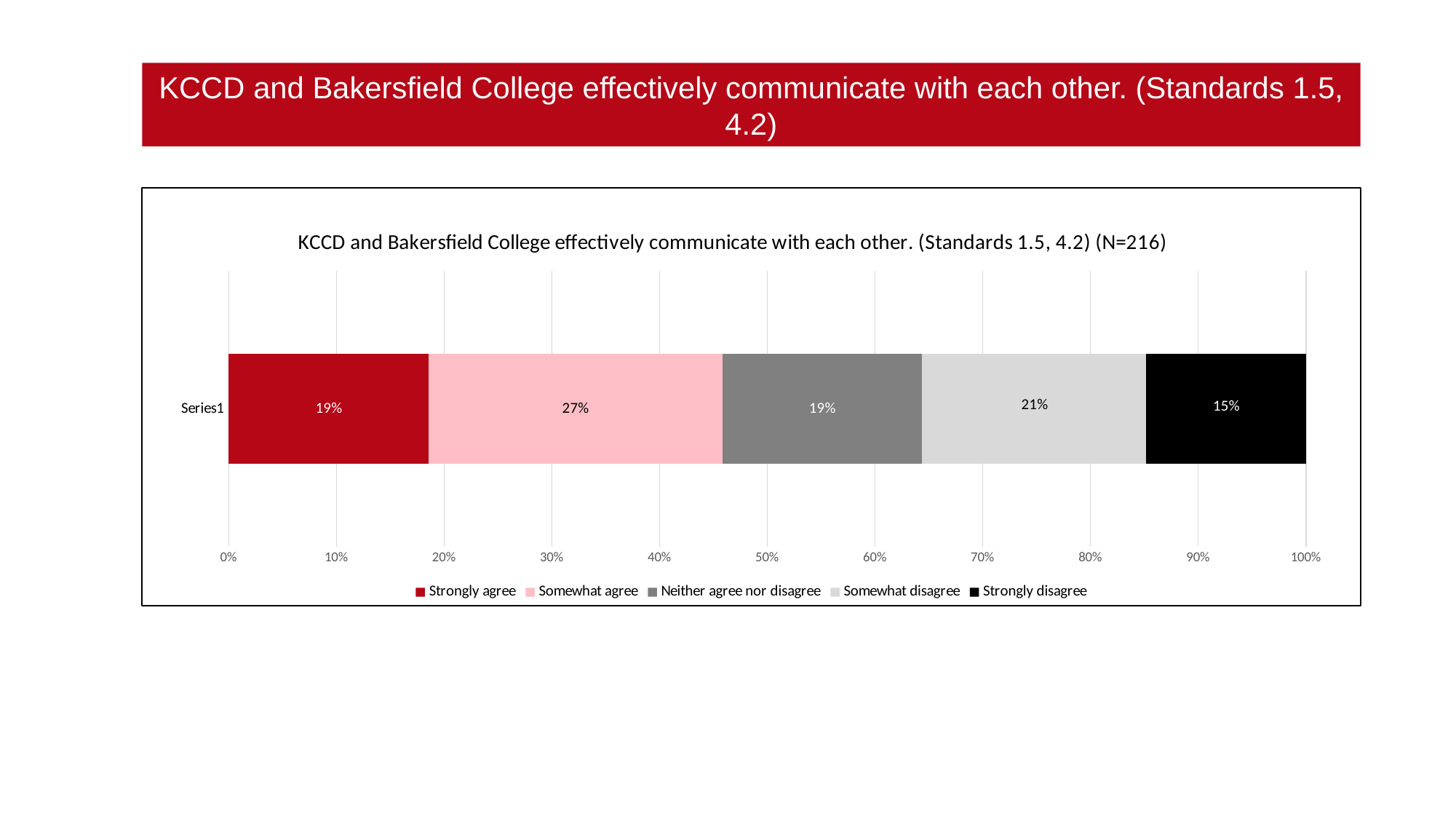
What percentage of respondents selected Strongly agree? 19% What percentage of respondents selected Strongly disagree? 15% What is the sample size (N) stated in the chart title? 216 What is the difference between the Somewhat agree and Strongly disagree percentages? 12% What percentage of respondents selected Somewhat agree? 27% Which is larger, the Somewhat disagree share or the Strongly agree share? Somewhat disagree What percentage of respondents selected Somewhat disagree? 21% What percentage of respondents selected Neither agree nor disagree? 19% Which response option has the largest share? Somewhat agree What kind of chart is shown on the slide? Stacked bar chart Which response option has the smallest share? Strongly disagree How many series does the legend list? 5